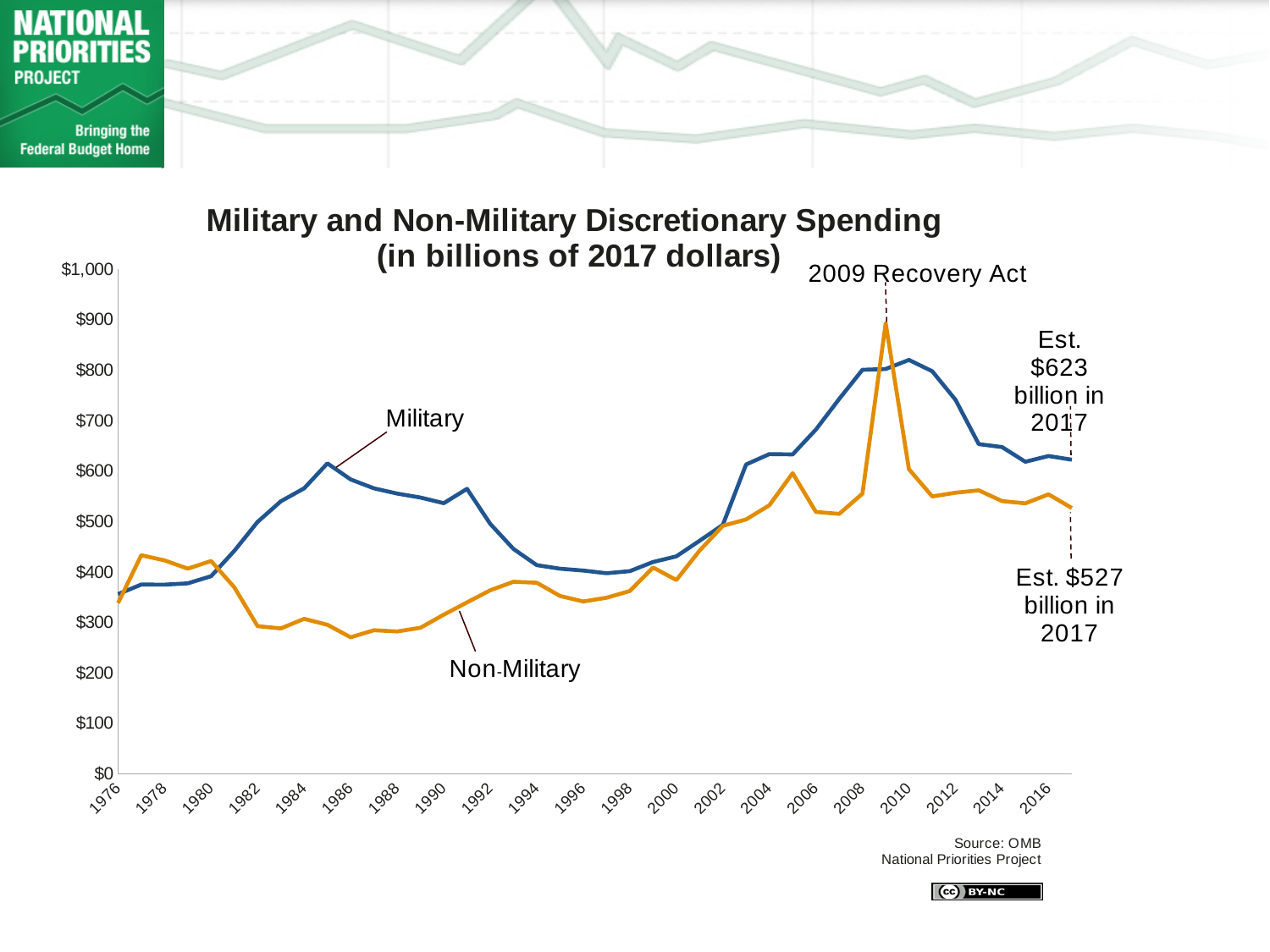
Does the Non-Military line rise or fall between 1980 and 1986? Fall How many series are plotted on the chart? 2 Is the Non-Military value at its 2009 peak greater or less than $800? greater Is the Military value in 1976 greater or less than $400? less Which event is annotated at the Non-Military spike in 2009? 2009 Recovery Act Does the Military line rise or fall between 1976 and 1985? Rise Which is larger in 2017, estimated Military or Non-Military spending? Military What is the estimated Non-Military discretionary spending in 2017? $527 billion What is the difference between the estimated Military and Non-Military spending in 2017? $96 billion What is the estimated Military discretionary spending in 2017? $623 billion What type of chart is shown on the slide? Line chart Is the Military value in 1994 greater or less than $500? less